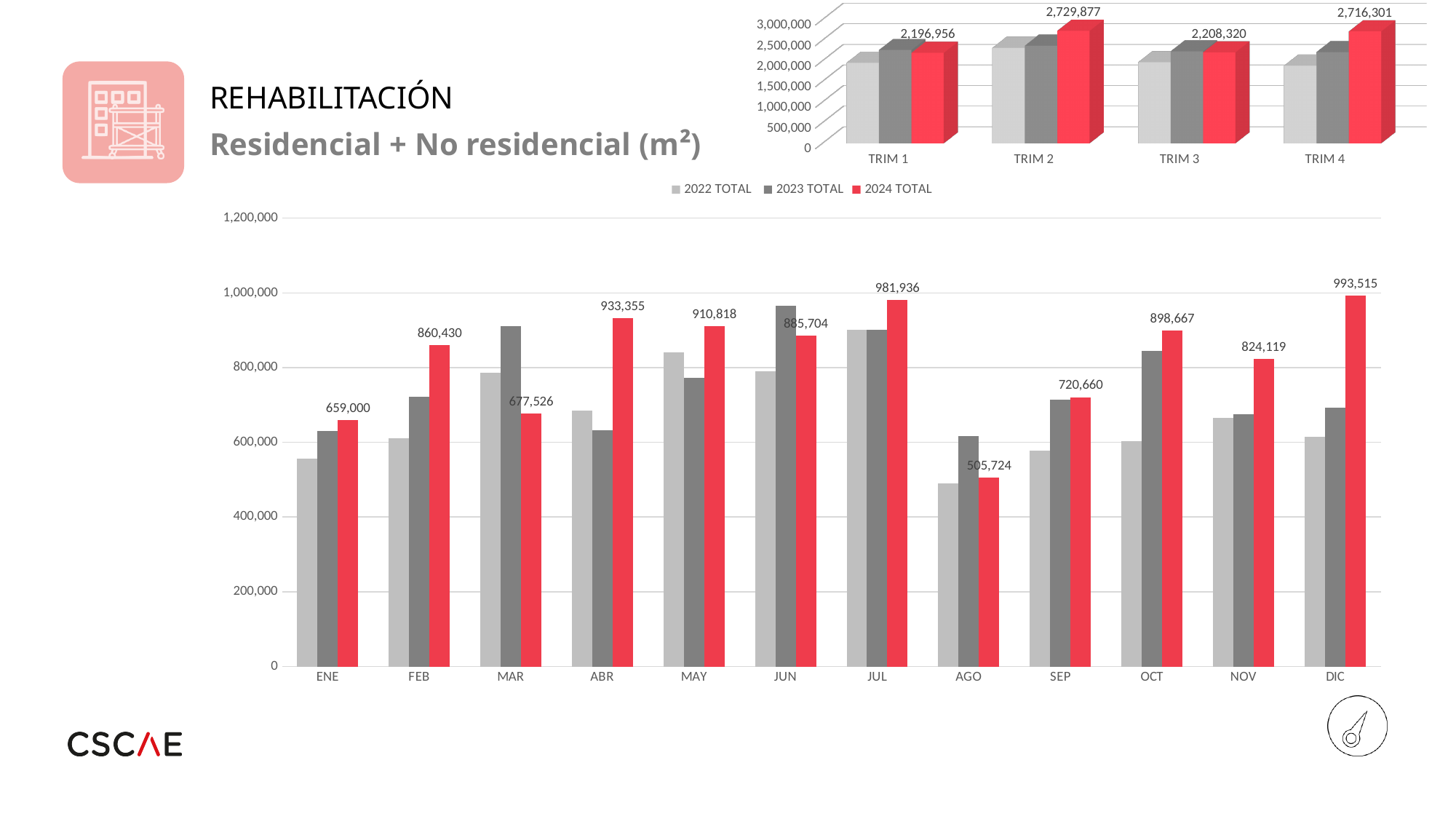
In the monthly chart, what is the 2024 TOTAL value for AGO? 505,724 In the monthly chart, is the 2022 TOTAL value for AGO greater or less than 600,000? less In the monthly chart, which is larger: the 2024 TOTAL for FEB or the 2024 TOTAL for MAR? FEB In the monthly chart, is the 2023 TOTAL value for MAR greater or less than 800,000? greater In the monthly chart, which month has the lowest 2024 TOTAL value? AGO How many series does the legend of the monthly chart list? 3 In the quarterly chart at the top right, what is the 2024 TOTAL value for TRIM 2? 2,729,877 In the monthly chart, what is the difference between the 2024 TOTAL values for DIC and AGO? 487,791 How many months are shown on the x axis of the monthly chart? 12 In the monthly chart, what is the 2024 TOTAL value for DIC? 993,515 In the monthly chart, which month has the highest 2024 TOTAL value? DIC In the quarterly chart at the top right, what is the difference between the 2024 TOTAL values for TRIM 2 and TRIM 1? 532,921